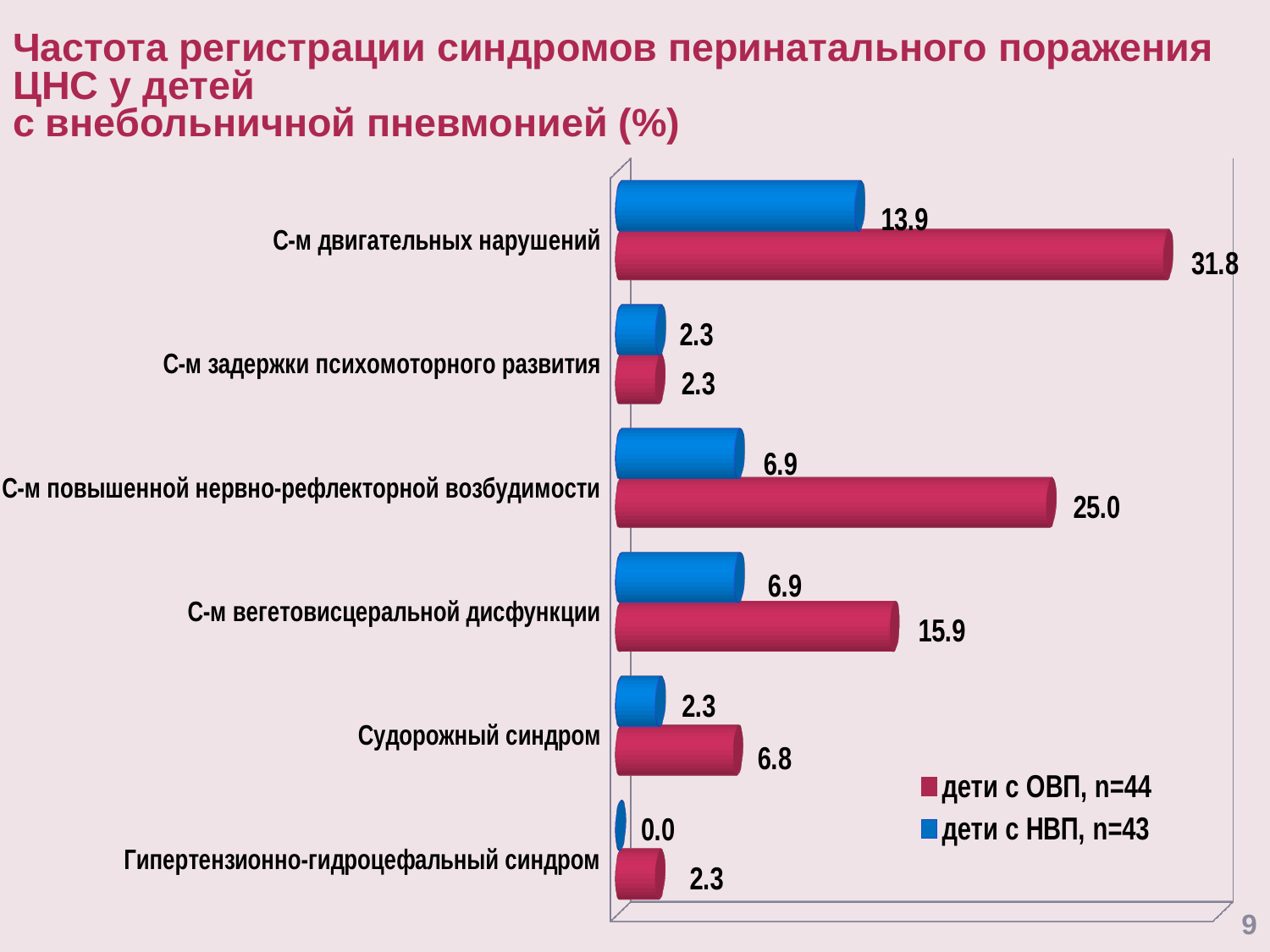
What is the difference between the "дети с ОВП, n=44" and "дети с НВП, n=43" values for "С-м повышенной нервно-рефлекторной возбудимости"? 18.1 What is the value for "С-м двигательных нарушений" in the series "дети с ОВП, n=44"? 31.8 What is the value for "С-м двигательных нарушений" in the series "дети с НВП, n=43"? 13.9 For "С-м вегетовисцеральной дисфункции", which series has the larger value: "дети с ОВП, n=44" or "дети с НВП, n=43"? дети с ОВП, n=44 What is the value for "Гипертензионно-гидроцефальный синдром" in the series "дети с НВП, n=43"? 0.0 Which category has the highest value in the series "дети с ОВП, n=44"? С-м двигательных нарушений How many syndrome categories are plotted on the chart? 6 What is the value for "Судорожный синдром" in the series "дети с ОВП, n=44"? 6.8 Which colour represents the series "дети с НВП, n=43" on the chart? Blue How many series does the legend list? 2 What type of chart is shown on the slide? Bar chart Which category has the lowest value in the series "дети с НВП, n=43"? Гипертензионно-гидроцефальный синдром